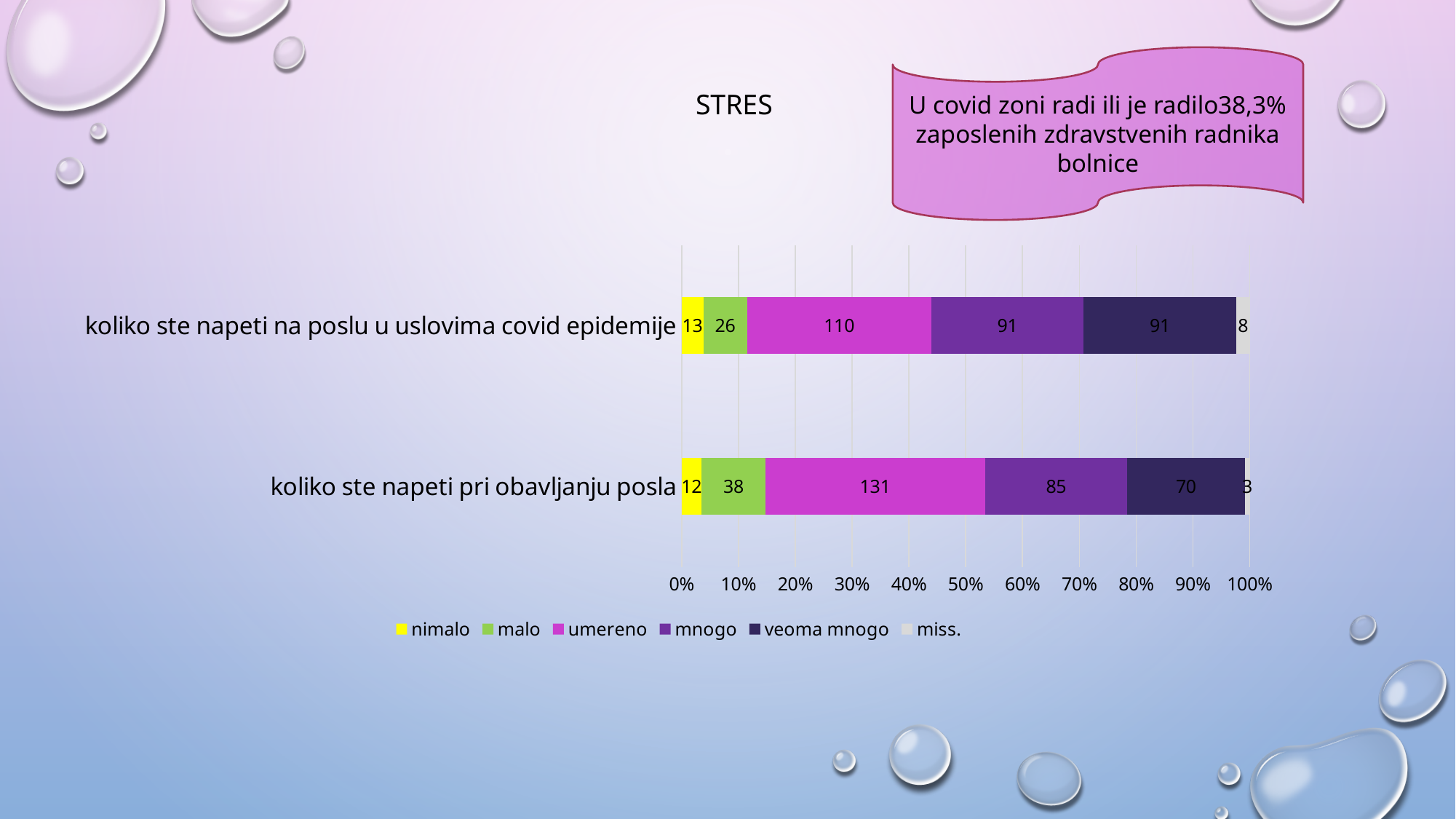
What is the value for "nimalo" in the bar "koliko ste napeti na poslu u uslovima covid epidemije"? 13 What is the value for "veoma mnogo" in the bar "koliko ste napeti pri obavljanju posla"? 70 Which bar has the larger value for "mnogo"? koliko ste napeti na poslu u uslovima covid epidemije What is the value for "malo" in the bar "koliko ste napeti pri obavljanju posla"? 38 Which series has the smallest value in the bar "koliko ste napeti na poslu u uslovima covid epidemije"? miss. What kind of chart is shown on the slide? Stacked bar chart What is the difference between the "umereno" values of the two bars? 21 How many series does the legend list? 6 What is the total of all segments in the bar "koliko ste napeti na poslu u uslovima covid epidemije"? 339 Which response category has the largest value in the bar "koliko ste napeti pri obavljanju posla"? umereno How many bars (categories) are shown in the chart? 2 What is the value for "umereno" in the bar "koliko ste napeti na poslu u uslovima covid epidemije"? 110